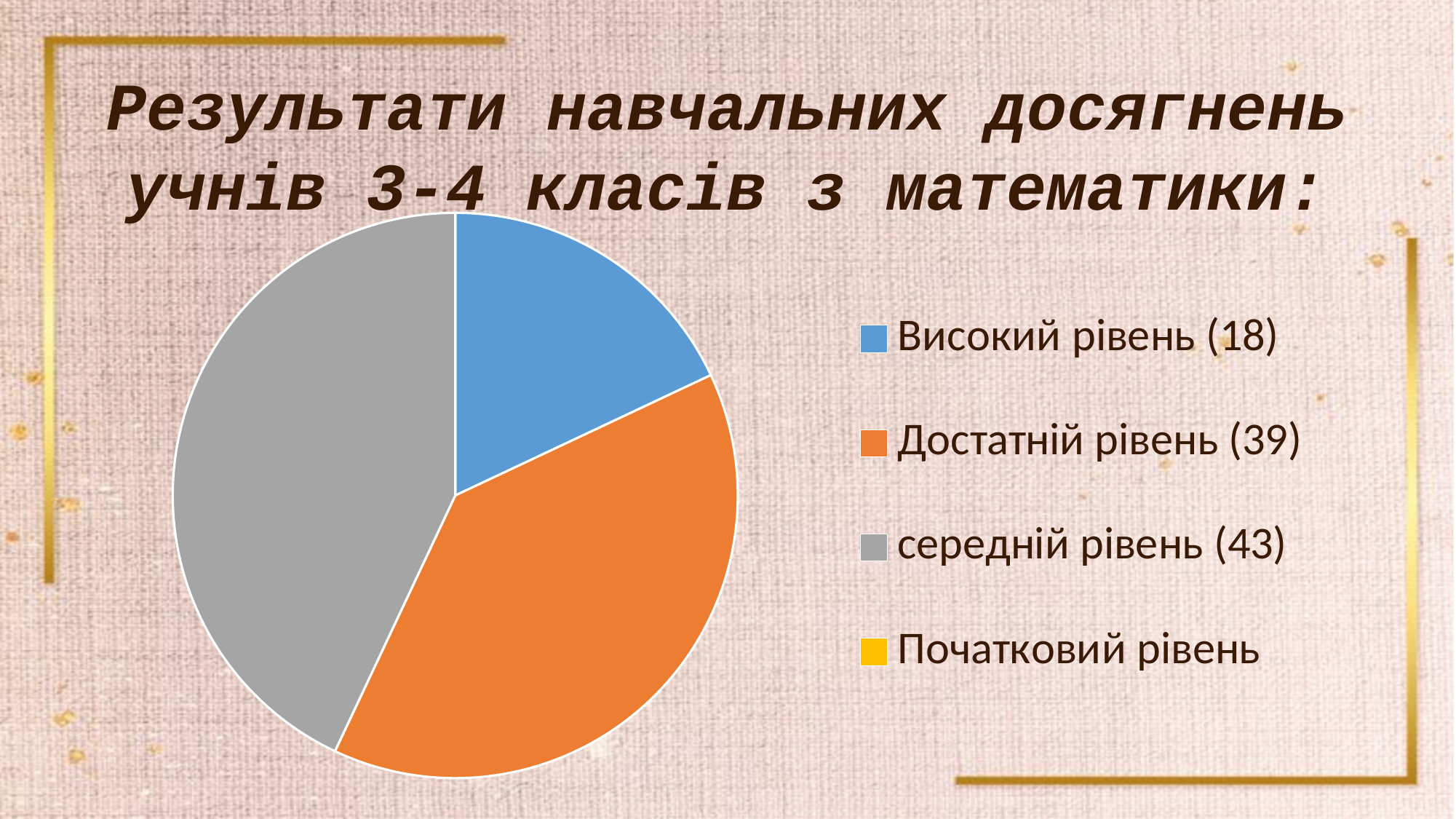
How many slices are visible in the pie chart? 3 What value is shown for середній рівень? 43 What kind of chart is shown on the slide? pie chart Which is larger, the value for Достатній рівень or the value for середній рівень? середній рівень What is the difference between the values for Достатній рівень and Високий рівень? 21 What is the difference between the values for середній рівень and Високий рівень? 25 What colour is the slice for Достатній рівень? orange What value is shown for Достатній рівень? 39 How many entries does the legend list? 4 Which category has the largest slice of the pie? середній рівень Which category with a value shown has the smallest slice of the pie? Високий рівень What value is shown for Високий рівень? 18